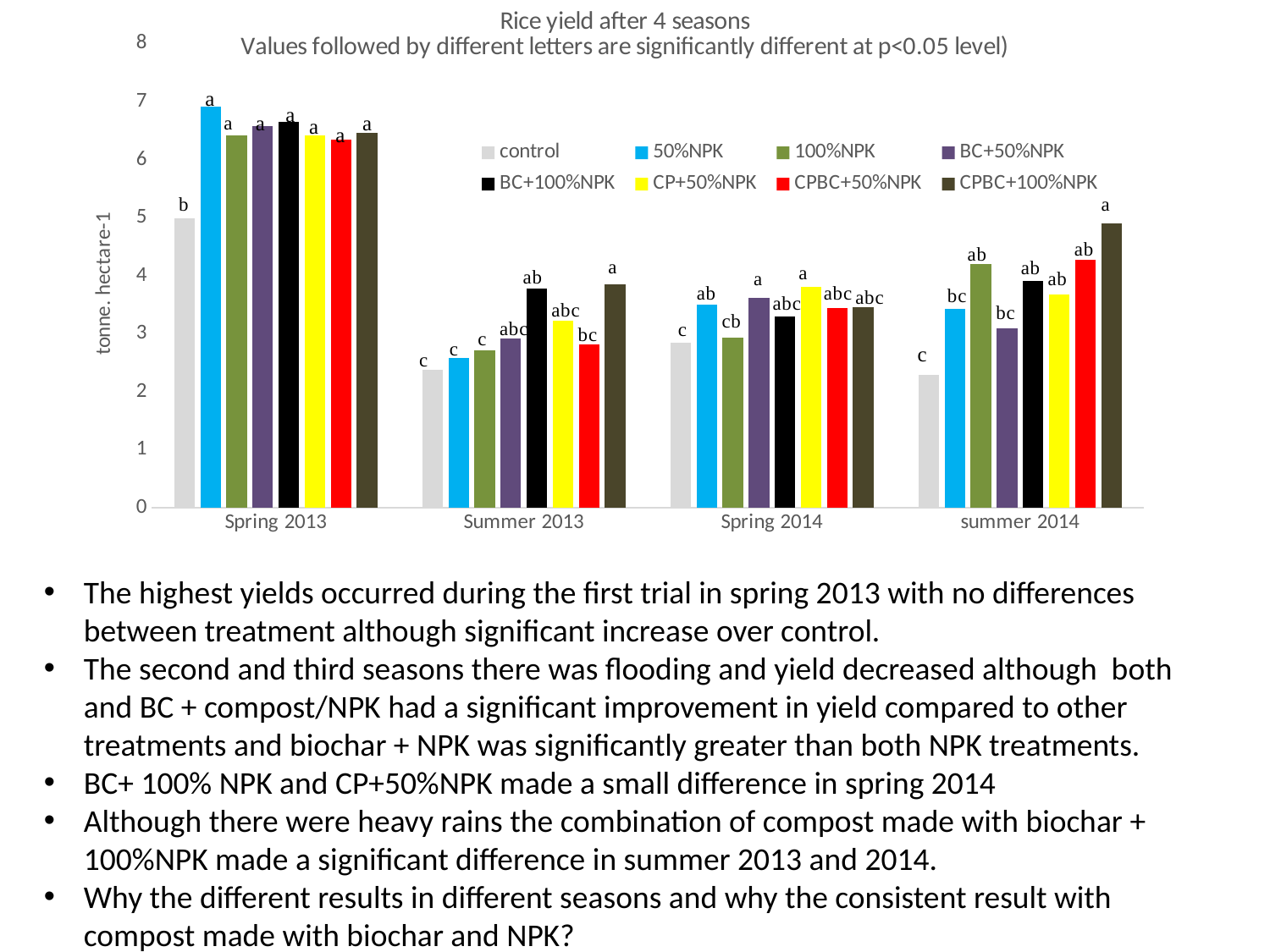
Which treatment has the lowest yield in Spring 2013? control How many treatments (series) does the legend list? 8 Is the control yield higher in Spring 2013 or in Summer 2013? Spring 2013 Which treatment has the highest yield in summer 2014? CPBC+100%NPK Which treatment has the lowest yield in summer 2014? control How many seasons (categories) are shown on the x axis? 4 Is the yield for CPBC+100%NPK in summer 2014 greater or less than 4? greater Is the yield for 50%NPK in Spring 2013 greater or less than 6? greater Is the yield for control in Summer 2013 greater or less than 3? less What kind of chart is shown on the slide? bar chart What is the label on the y axis of the chart? tonne. hectare-1 In Spring 2013, which is larger: the yield for control or for 50%NPK? 50%NPK